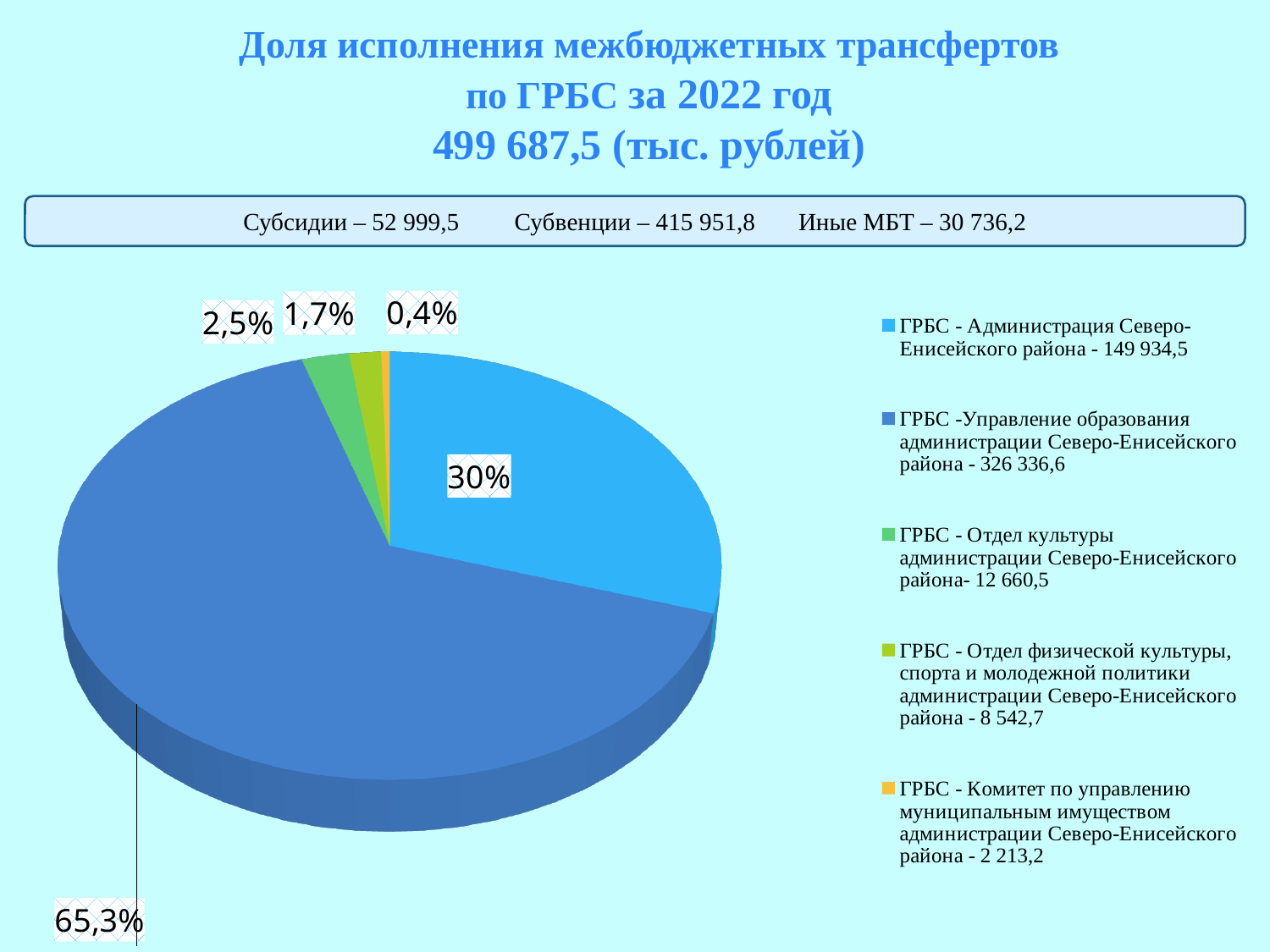
What is the difference in percentage points between the 65,3% slice and the 30% slice? 35,3 What share of the pie does ГРБС - Администрация Северо-Енисейского района have? 30% How many entries does the legend list? 5 What share of the pie does ГРБС - Отдел культуры администрации Северо-Енисейского района have? 2,5% Which is larger: the share for ГРБС - Отдел культуры or the share for ГРБС - Отдел физической культуры, спорта и молодежной политики? ГРБС - Отдел культуры Which category has the smallest slice of the pie? ГРБС - Комитет по управлению муниципальным имуществом администрации Северо-Енисейского района What share of the pie does ГРБС - Управление образования администрации Северо-Енисейского района have? 65,3% Which category has the largest slice of the pie? ГРБС - Управление образования администрации Северо-Енисейского района What kind of chart is shown on the slide? pie chart How many slices does the pie chart have? 5 What value does the legend give for ГРБС - Администрация Северо-Енисейского района? 149 934,5